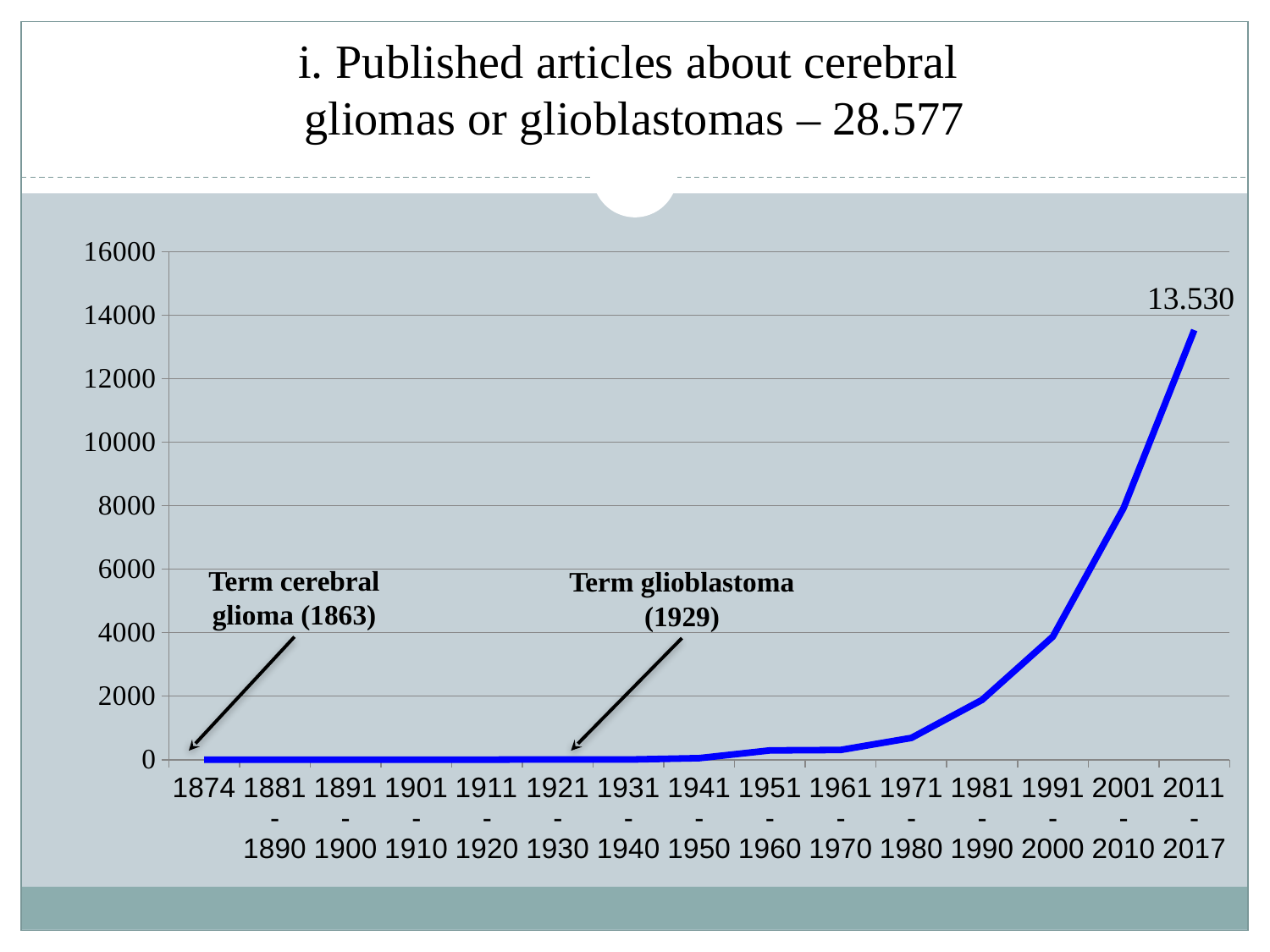
Which period has the larger value, 1991-2000 or 2001-2010? 2001-2010 Do the values generally rise or fall from left to right along the x axis? rise According to the annotation, in what year was the term glioblastoma introduced? 1929 Is the value for 1991-2000 greater or less than 2000? greater Which period has the highest number of published articles? 2011-2017 Is the value for 1971-1980 greater or less than 2000? less Is the value for 1981-1990 greater or less than 4000? less What type of chart is shown on the slide? line chart How many periods are shown along the x axis? 15 What is the highest value shown on the y axis? 16000 What value is labelled for the 2011-2017 period? 13.530